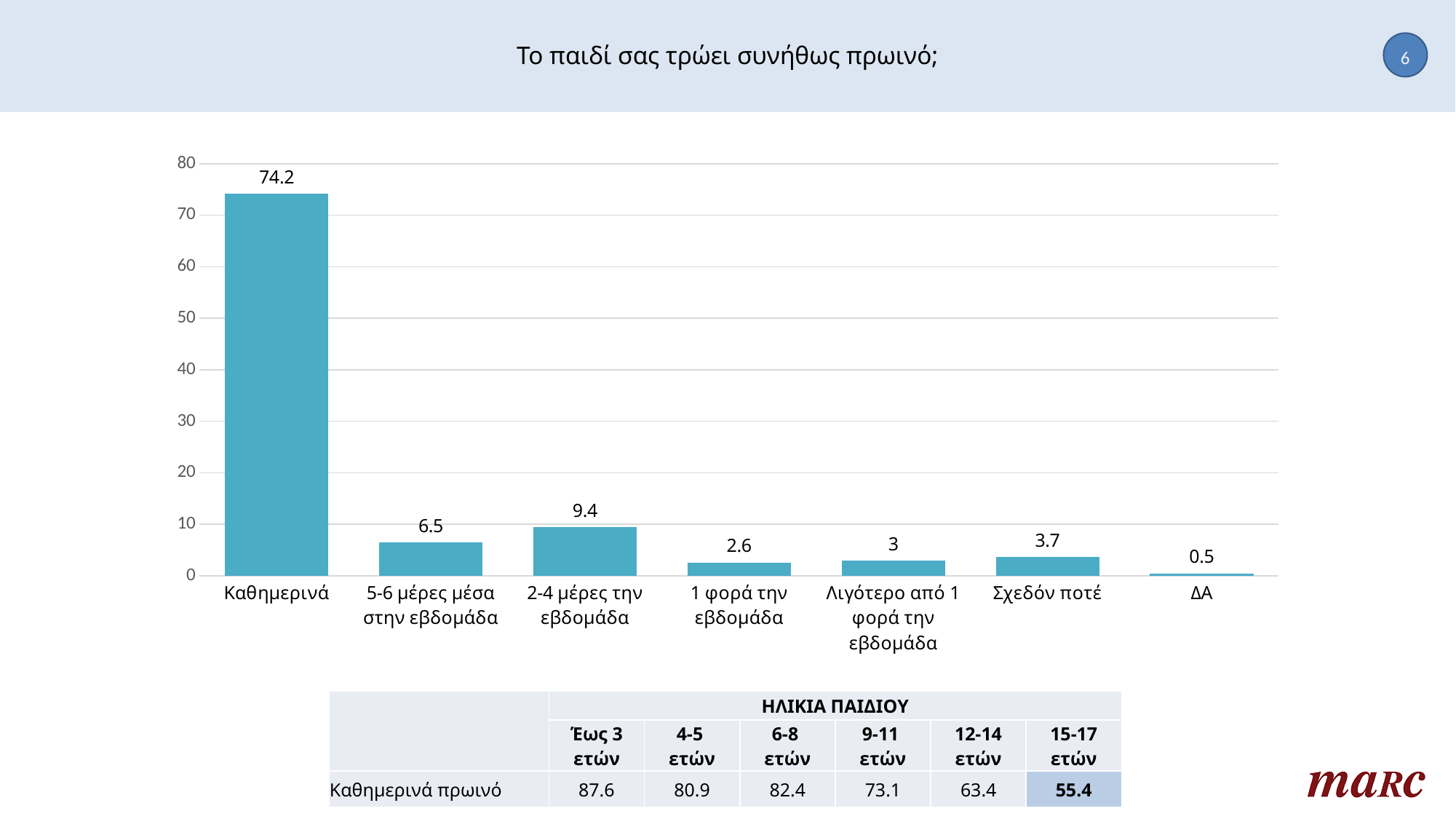
Which is larger, the value for Σχεδόν ποτέ or the value for Λιγότερο από 1 φορά την εβδομάδα? Σχεδόν ποτέ What is the difference between the values for Καθημερινά and 2-4 μέρες την εβδομάδα? 64.8 Which category has the lowest value? ΔΑ What is the value for ΔΑ? 0.5 What kind of chart is shown on the slide? bar chart What is the value for Καθημερινά? 74.2 How many categories are shown on the x axis of the chart? 7 What is the value for 2-4 μέρες την εβδομάδα? 9.4 Is the value for Καθημερινά greater or less than 70? greater Which category has the highest value? Καθημερινά What is the value for Σχεδόν ποτέ? 3.7 What is the difference between the values for 5-6 μέρες μέσα στην εβδομάδα and 1 φορά την εβδομάδα? 3.9